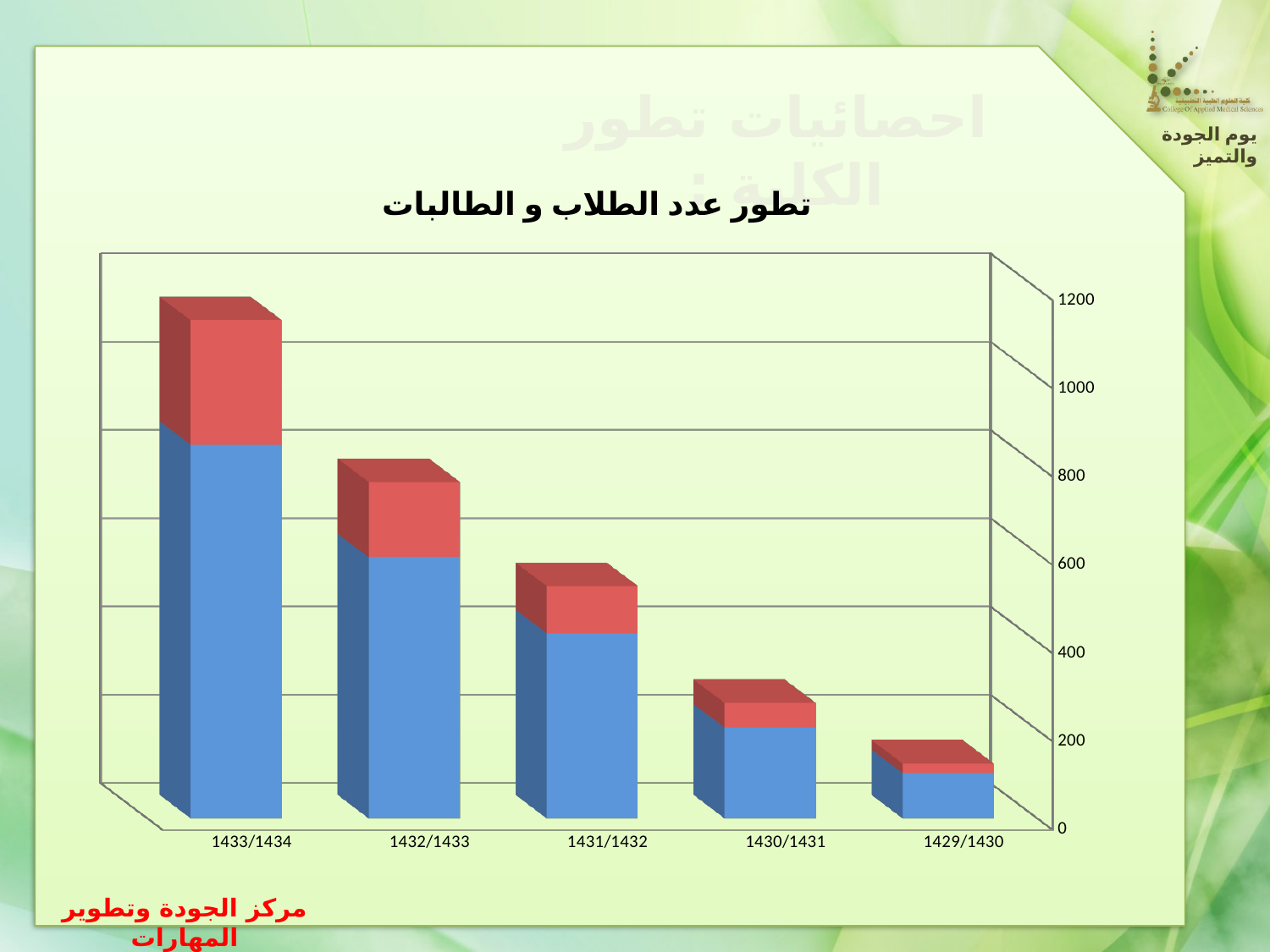
What is the title of the chart? تطور عدد الطلاب و الطالبات What is the highest value shown on the vertical axis? 1200 Do the stacked bar totals rise or fall moving from left to right along the x axis? Fall Which academic year has the tallest stacked bar? 1433/1434 Is the total stacked value for 1433/1434 greater or less than 1000? greater What kind of chart is shown on the slide? Stacked bar chart Is the total stacked value for 1432/1433 greater or less than 600? greater Which has the larger stacked bar, 1431/1432 or 1430/1431? 1431/1432 Is the total stacked value for 1430/1431 greater or less than 400? less Which academic year has the shortest stacked bar? 1429/1430 How many academic-year categories are shown on the x axis? 5